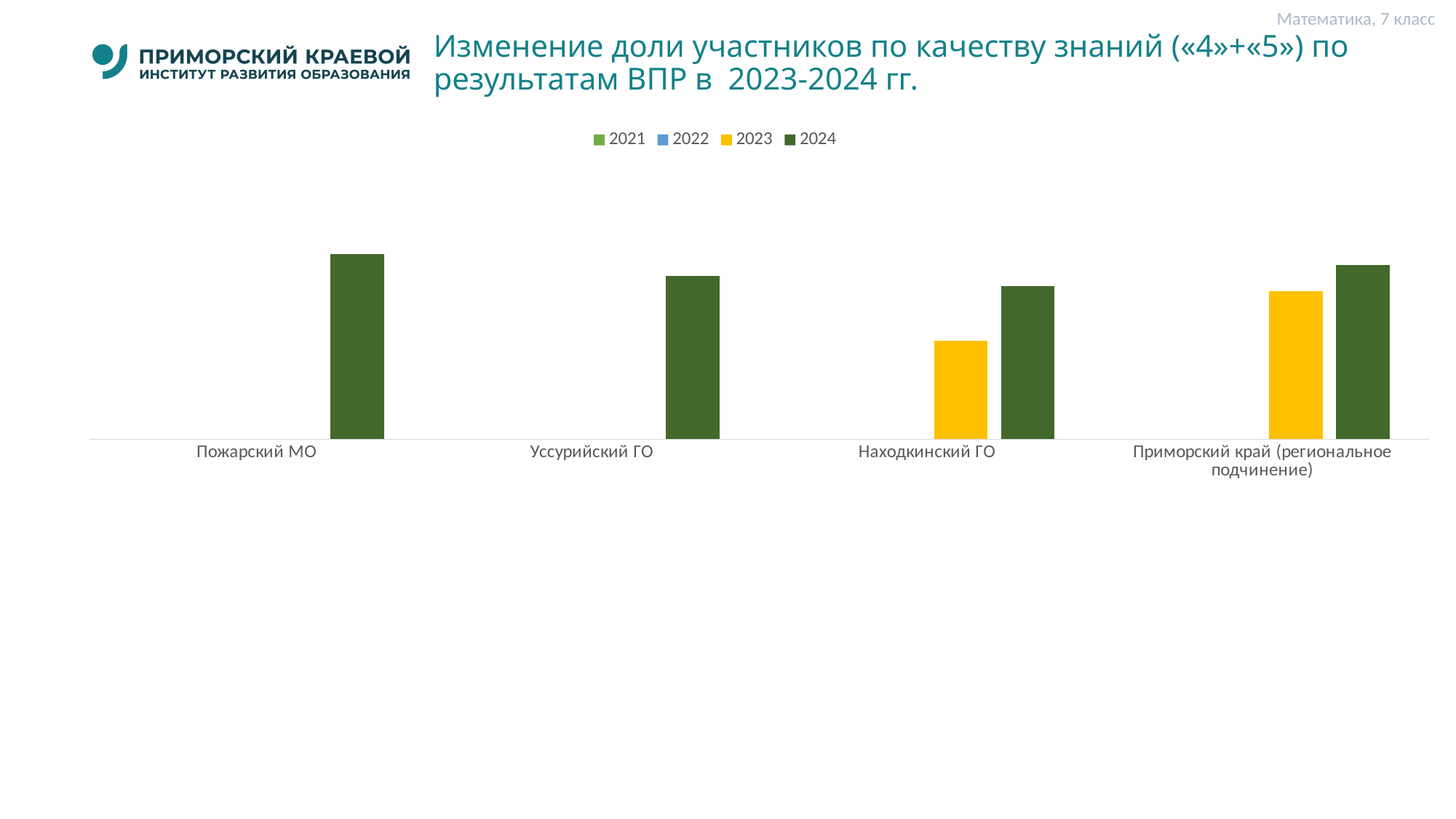
Which categories have a 2023 bar plotted? Находкинский ГО and Приморский край (региональное подчинение) Which is larger for Приморский край (региональное подчинение): the 2023 bar or the 2024 bar? 2024 Which category has the higher 2024 bar: Пожарский МО or Уссурийский ГО? Пожарский МО Which is larger for Находкинский ГО: the 2023 bar or the 2024 bar? 2024 What colour are the 2023 bars in the chart? yellow How many series does the chart legend list? 4 What years are listed in the chart legend? 2021, 2022, 2023, 2024 Which category has the tallest 2024 bar? Пожарский МО How many categories are shown on the x axis of the chart? 4 Which category has the lowest 2024 bar? Находкинский ГО What kind of chart is shown on the slide? bar chart